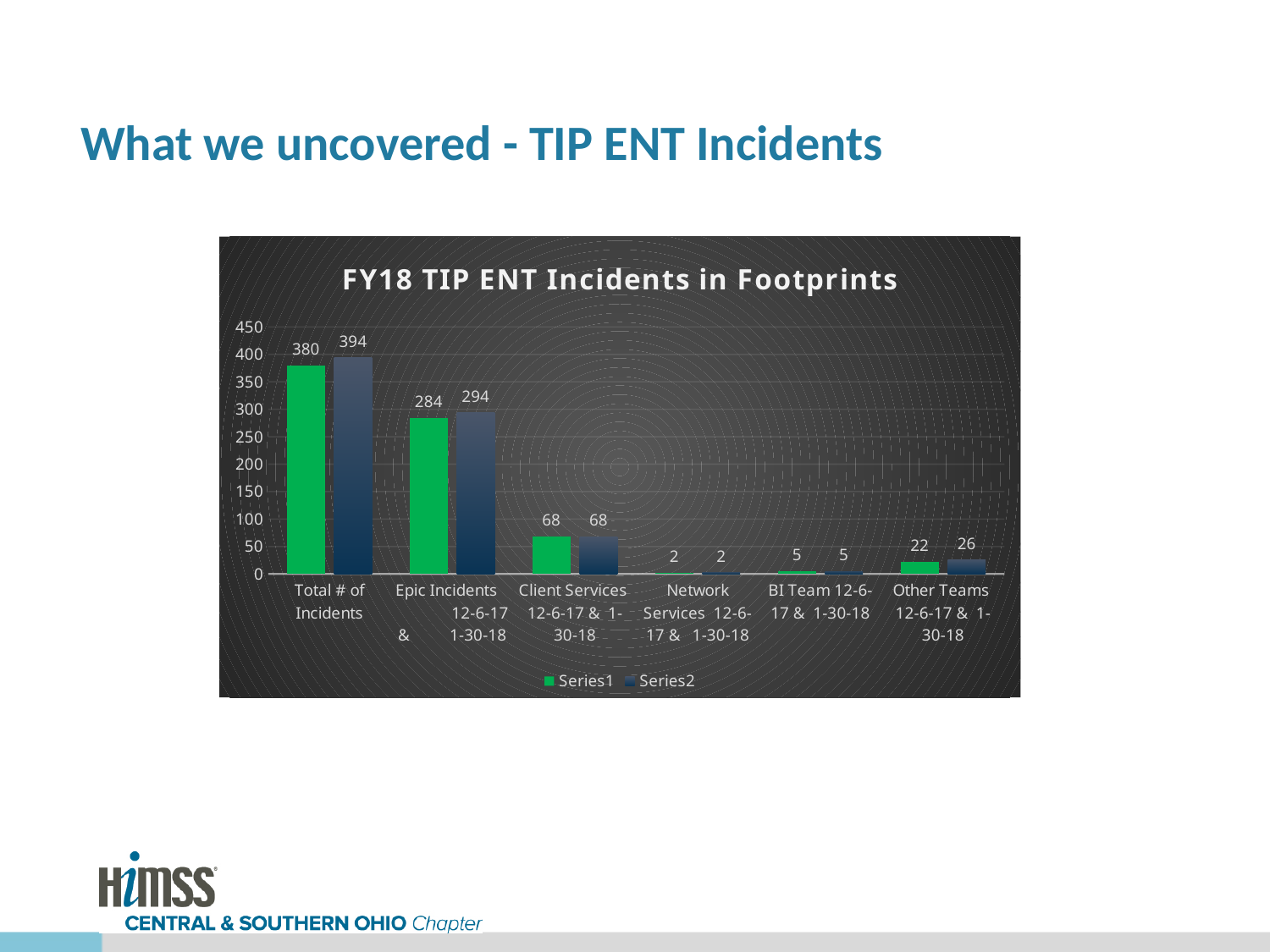
Which category has the lowest Series2 value? Network Services 12-6-17 & 1-30-18 What is the title of the chart? FY18 TIP ENT Incidents in Footprints What is the Series1 value for Other Teams 12-6-17 & 1-30-18? 22 What is the difference between the Series1 values for Epic Incidents 12-6-17 & 1-30-18 and Client Services 12-6-17 & 1-30-18? 216 What kind of chart is shown on the slide? Bar chart Which category has the highest Series1 value? Total # of Incidents What is the Series1 value for Total # of Incidents? 380 Which is larger for Other Teams 12-6-17 & 1-30-18, Series1 or Series2? Series2 How many series does the legend list? 2 What is the difference between the Series2 and Series1 values for Total # of Incidents? 14 How many categories are shown on the x axis? 6 What is the Series2 value for Epic Incidents 12-6-17 & 1-30-18? 294